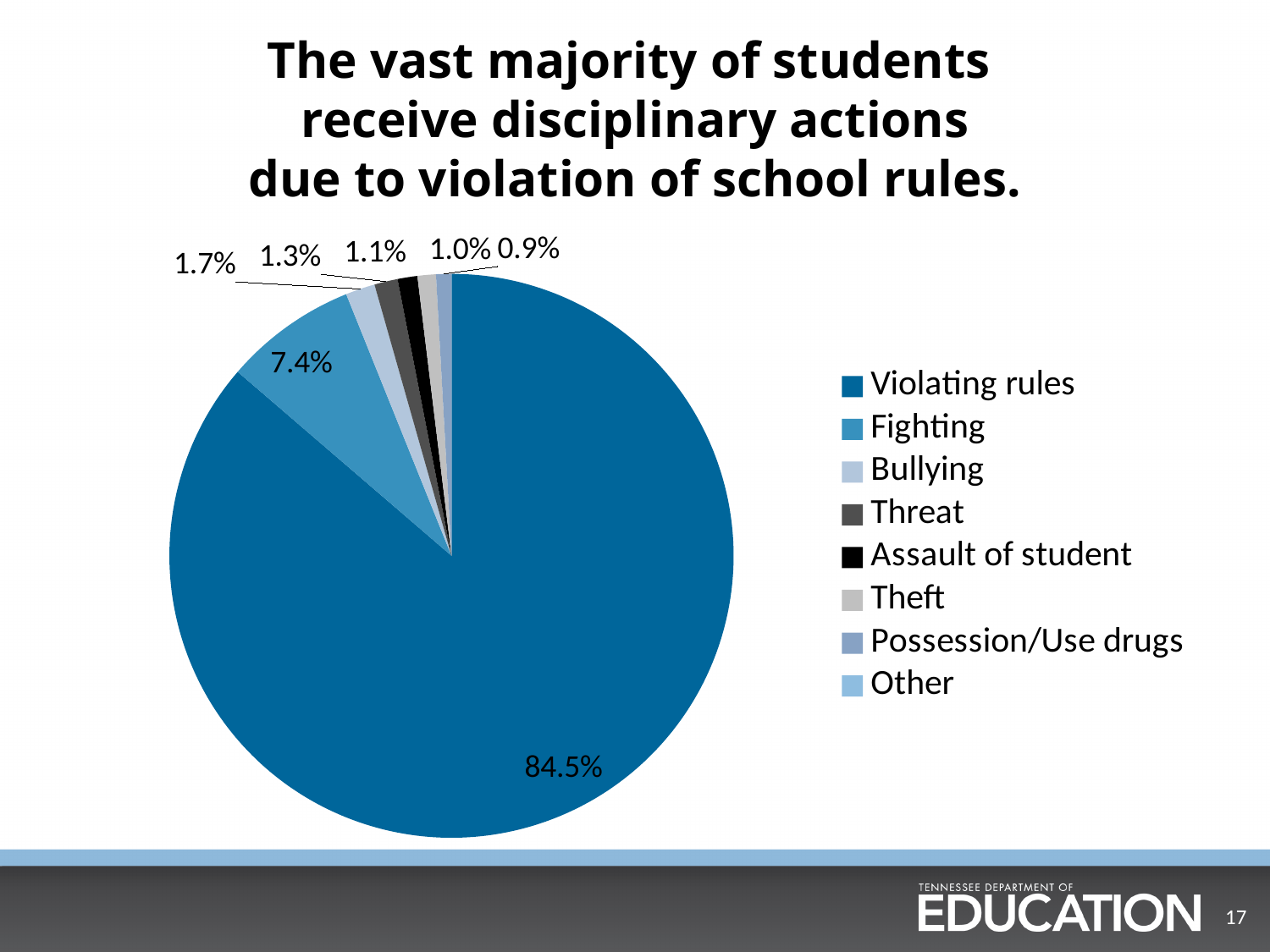
What share of the pie is labelled for Assault of student? 1.1% How many categories does the legend of the pie chart list? 8 What share of the pie is labelled for Violating rules? 84.5% What is the difference in percentage points between the Violating rules share and the Fighting share? 77.1 percentage points What is the title of the slide containing the pie chart? The vast majority of students receive disciplinary actions due to violation of school rules. What share of the pie is labelled for Bullying? 1.7% What share of the pie is labelled for Fighting? 7.4% Which is larger, the share for Fighting or the share for Bullying? Fighting Which category has the largest slice of the pie chart? Violating rules What kind of chart is shown on the slide? Pie chart What is the combined share of Violating rules and Fighting? 91.9% What share of the pie is labelled for Threat? 1.3%